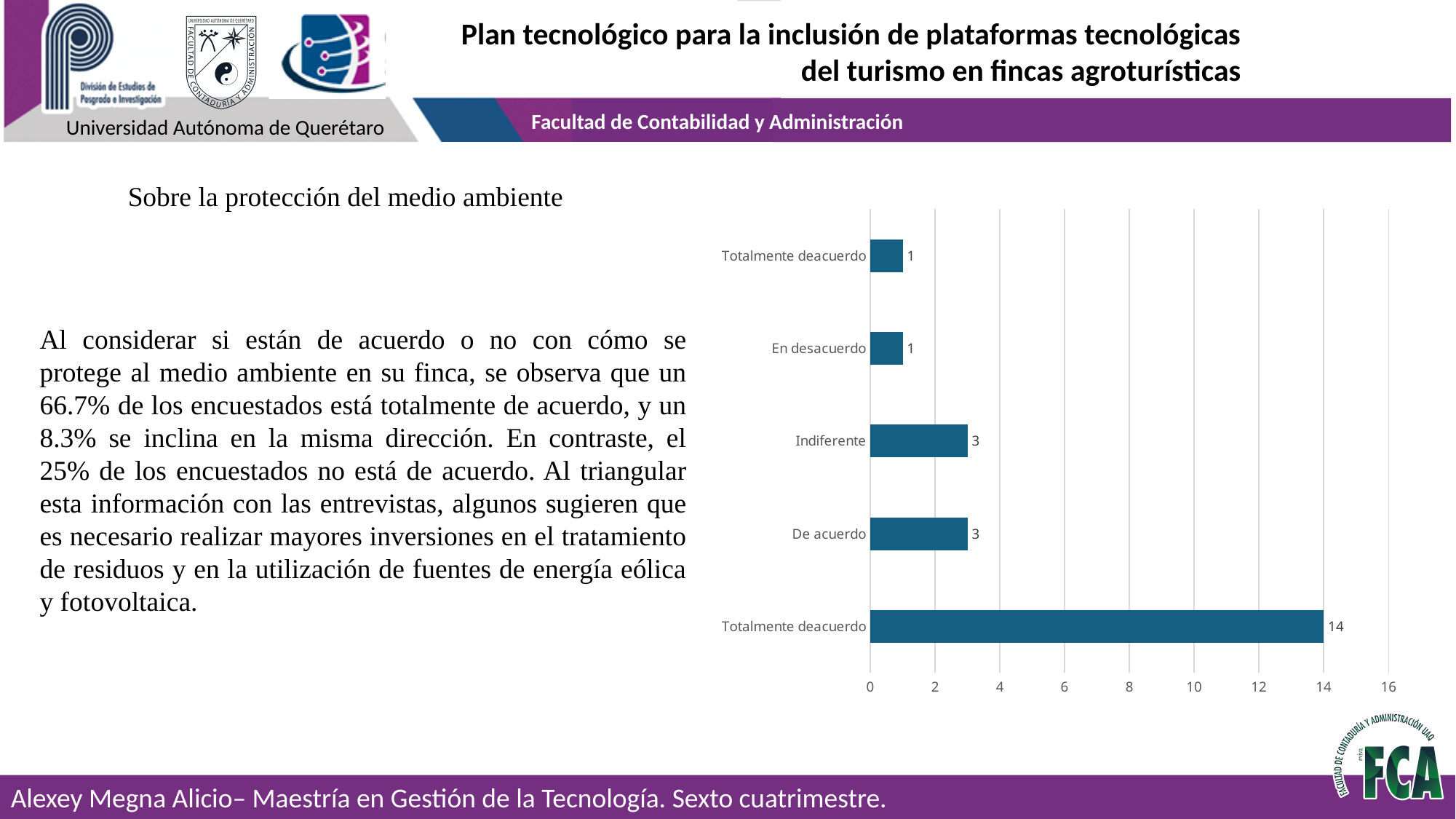
What is the value for "En desacuerdo" in the bar chart? 1 What is the value of the topmost bar in the bar chart? 1 How many categories does the bar chart show? 5 Is the value of the bottom bar in the bar chart greater or less than 12? greater What is the difference between the value of the bottom bar (14) and the value for "De acuerdo" in the bar chart? 11 What is the value for "Indiferente" in the bar chart? 3 What is the maximum value shown on the horizontal axis of the bar chart? 16 What is the value of the bottom bar, labelled "Totalmente deacuerdo", in the bar chart? 14 Which category has the highest value in the bar chart? Totalmente deacuerdo (bottom bar) What is the value for "De acuerdo" in the bar chart? 3 What kind of chart is shown on the slide? bar chart Which is larger in the bar chart: the value for "Indiferente" or the value for "En desacuerdo"? Indiferente